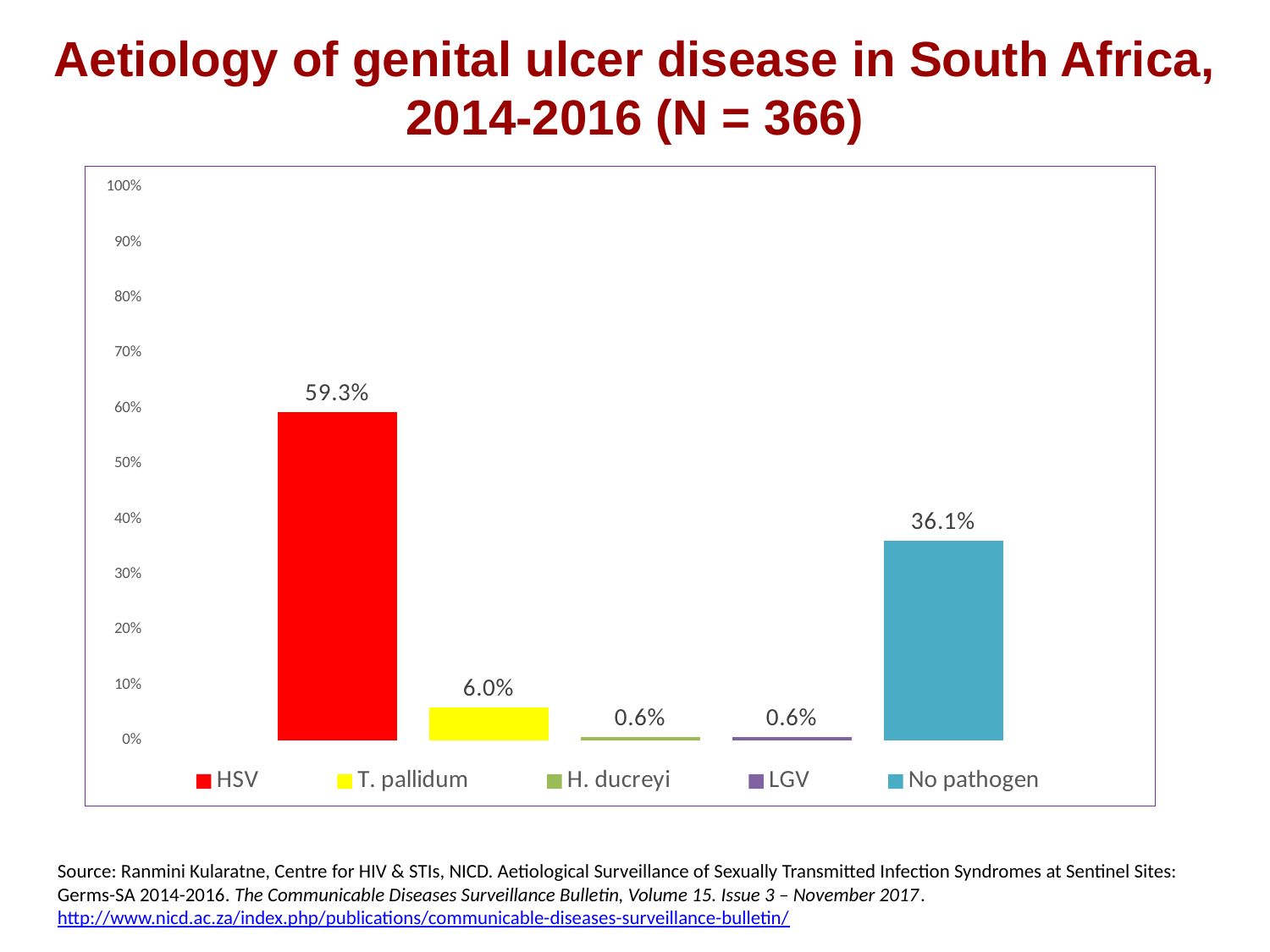
What is the sample size (N) given in the slide title? 366 What percentage is shown for T. pallidum? 6.0% What percentage is shown for H. ducreyi? 0.6% What colour is the bar for HSV? Red Which category has the highest percentage? HSV How many categories are shown in the legend? 5 What percentage is shown for HSV? 59.3% Is the value for HSV greater or less than 50%? greater What kind of chart is shown on the slide? Bar chart What percentage is shown for No pathogen? 36.1% Which is larger, the value for T. pallidum or the value for No pathogen? No pathogen What is the difference in percentage points between HSV and No pathogen? 23.2